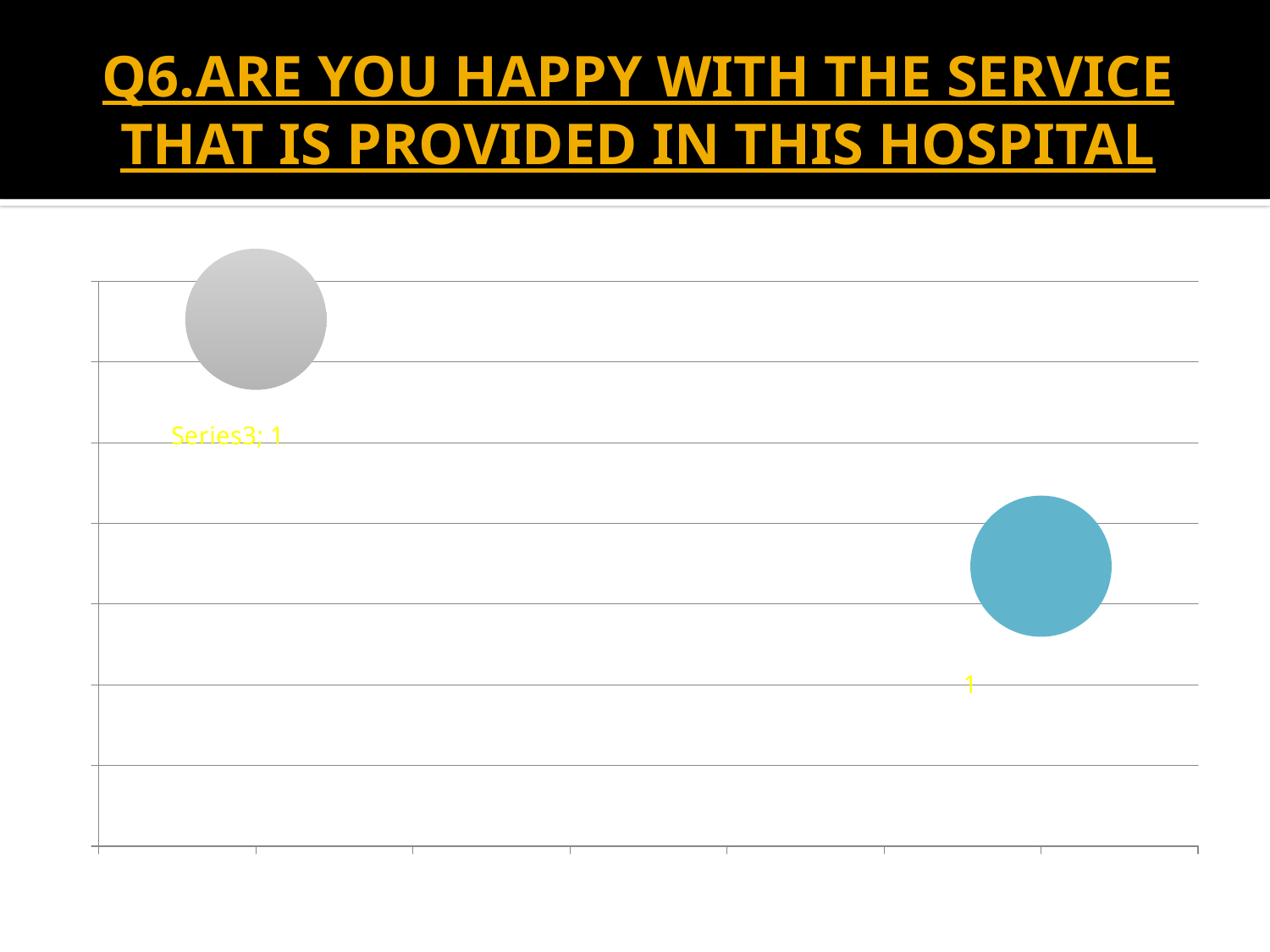
What value is printed as the data label below the blue bubble? 1 What value is printed in the data label for Series3? 1 Which bubble is positioned further to the right on the chart, the grey one or the blue one? the blue one How many bubbles are plotted on the chart? 2 What is the title of the slide containing the chart? Q6.ARE YOU HAPPY WITH THE SERVICE THAT IS PROVIDED IN THIS HOSPITAL What kind of chart is shown on the slide? bubble chart What colour is the bubble labelled Series3? grey What data label is shown next to the grey bubble? Series3; 1 Which bubble is positioned higher on the chart, the grey one or the blue one? the grey one